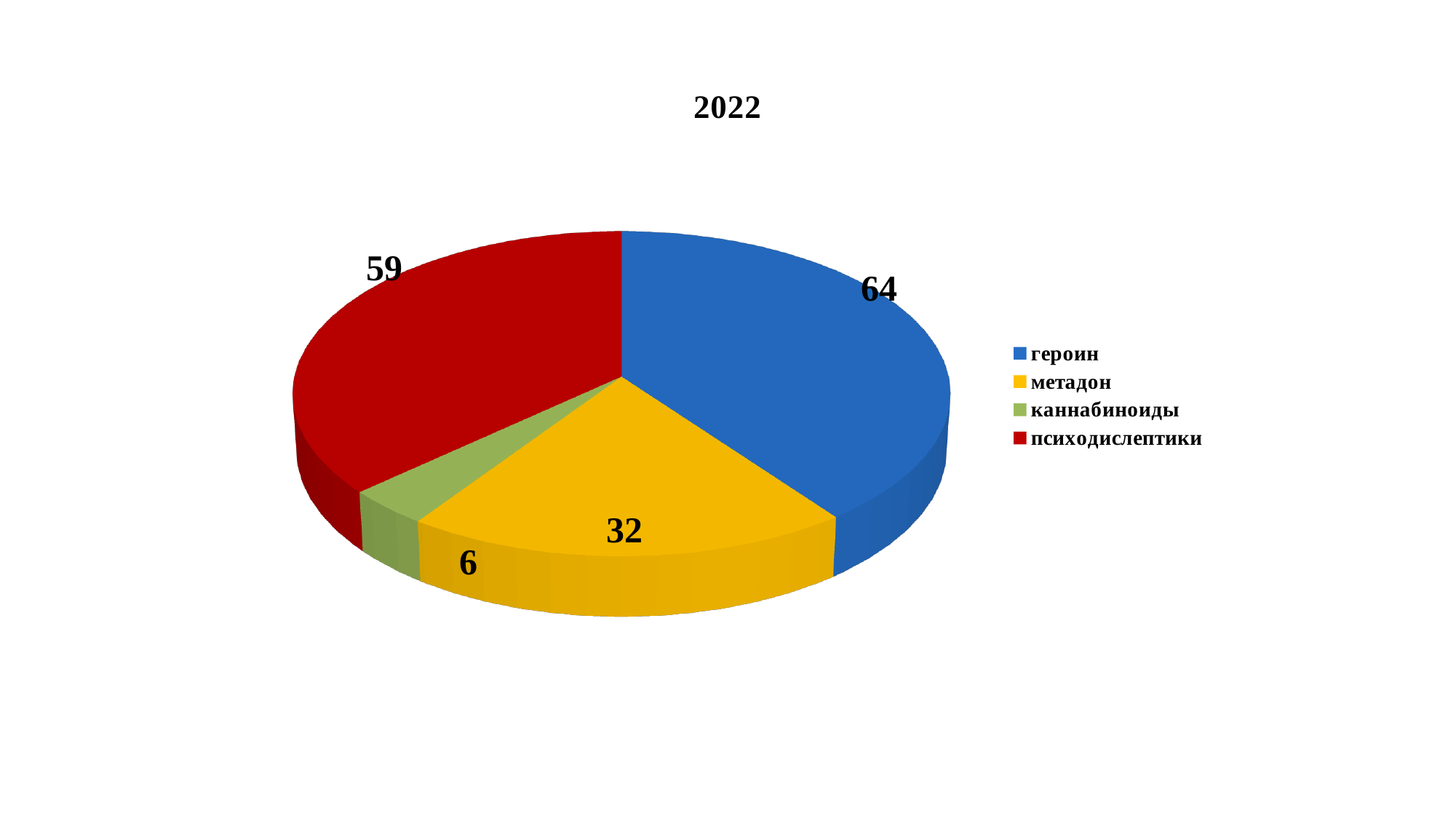
Which category has the smallest slice? каннабиноиды Which is larger, the value for психодислептики or the value for метадон? психодислептики What is the difference between the values for героин and метадон? 32 What is the title of the chart? 2022 What is the value for героин? 64 What is the value for психодислептики? 59 What is the value for метадон? 32 How many categories does the legend list? 4 What type of chart is shown on the slide? pie chart What colour is the slice for психодислептики? red What is the value for каннабиноиды? 6 Which category has the largest slice? героин